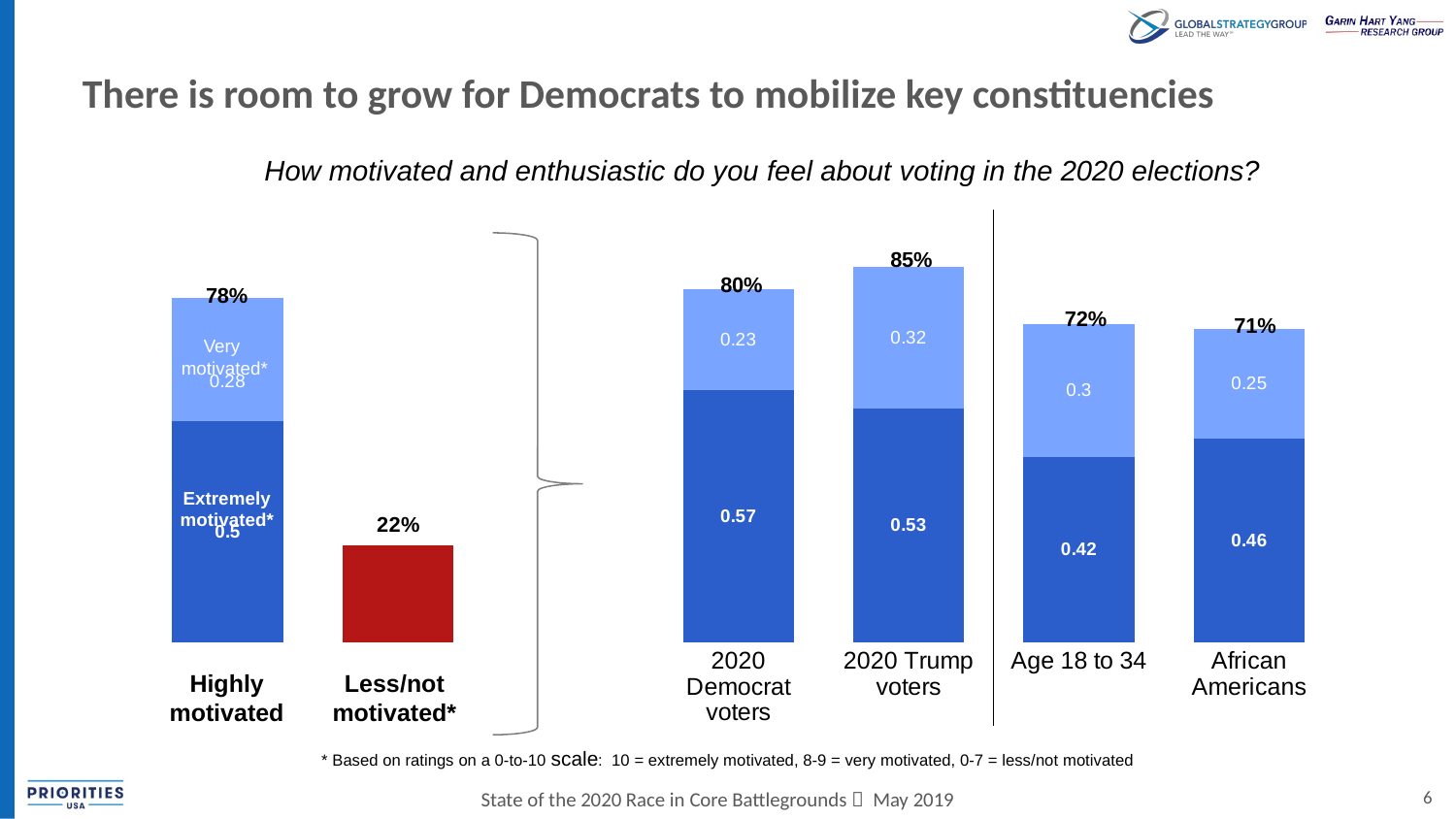
In the left-hand chart, what is the 'Extremely motivated' value within the 'Highly motivated' bar? 0.5 In the right-hand chart, what is the 'Extremely motivated' value for 2020 Democrat voters? 0.57 How many groups are shown on the x axis of the right-hand chart? 4 In the right-hand chart, what is the total highly motivated share shown above the bar for 2020 Trump voters? 85% In the right-hand chart, what is the difference between the total shares for 2020 Trump voters and 2020 Democrat voters? 5% In the right-hand chart, which group has the highest total highly motivated share? 2020 Trump voters In the right-hand chart, what is the 'Very motivated' value for Age 18 to 34? 0.3 What kind of chart is the right-hand chart? Stacked bar chart In the left-hand chart, what is the total shown above the 'Highly motivated' stacked bar? 78% In the right-hand chart, which is larger: the 'Extremely motivated' value for African Americans or for Age 18 to 34? African Americans In the left-hand chart, what is the value shown for 'Less/not motivated'? 22% In the right-hand chart, which group has the lowest total highly motivated share? African Americans